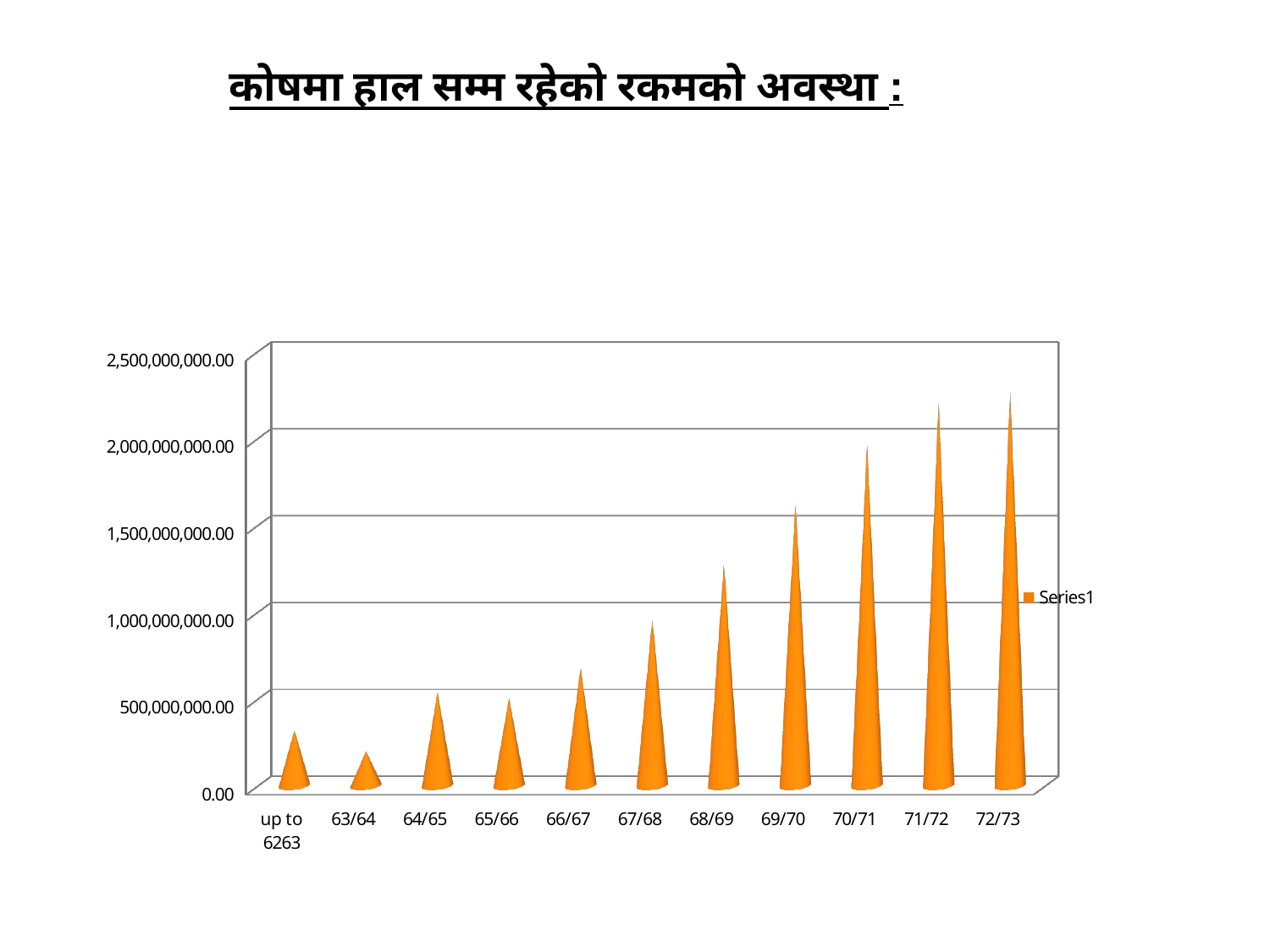
Is the value for 68/69 greater or less than 1,000,000,000.00? greater Do the values generally rise or fall from left to right along the x axis? rise How many series does the chart's legend list? 1 Which category has the lowest value in the chart? 63/64 Which has the larger value, 70/71 or 66/67? 70/71 How many categories are shown on the x axis of the chart? 11 Is the value for 72/73 greater or less than 2,000,000,000.00? greater Is the value for 66/67 greater or less than 500,000,000.00? greater What kind of chart is shown on the slide? bar chart Which category has the highest value in the chart? 72/73 What is the name of the series shown in the legend? Series1